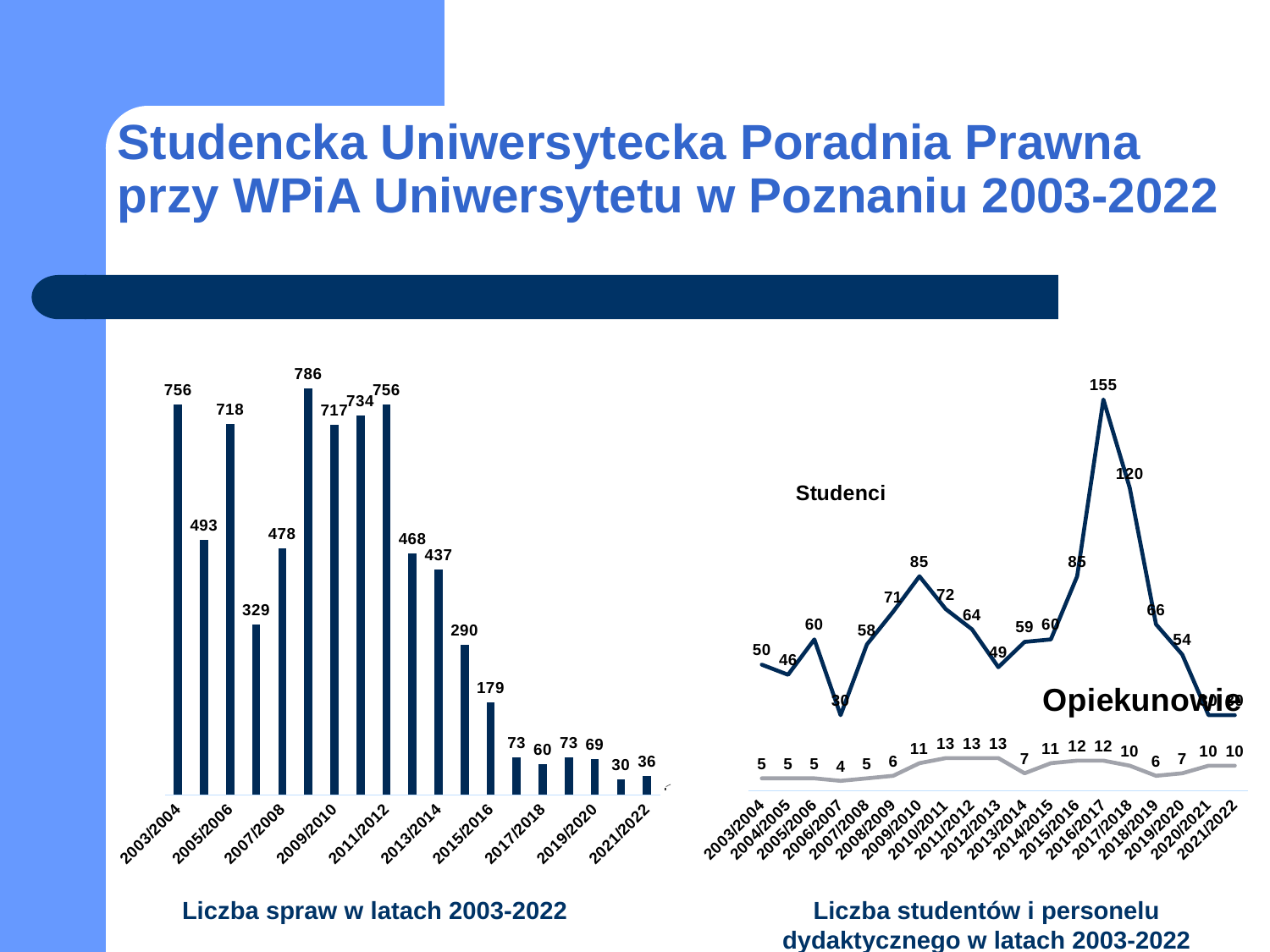
In the right chart 'Liczba studentów i personelu dydaktycznego w latach 2003-2022', what is the Studenci value for 2009/2010? 85 In the left chart 'Liczba spraw w latach 2003-2022', what is the value for 2003/2004? 756 How many series are plotted in the right chart 'Liczba studentów i personelu dydaktycznego w latach 2003-2022'? 2 In the right chart 'Liczba studentów i personelu dydaktycznego w latach 2003-2022', in which year does the Studenci series reach its highest value? 2016/2017 In the left chart 'Liczba spraw w latach 2003-2022', do the values rise or fall from 2011/2012 to 2021/2022? fall How many bars are plotted in the left chart 'Liczba spraw w latach 2003-2022'? 19 In the right chart 'Liczba studentów i personelu dydaktycznego w latach 2003-2022', what is the Opiekunowie value for 2006/2007? 4 In the left chart 'Liczba spraw w latach 2003-2022', which has the larger value, 2005/2006 or 2007/2008? 2005/2006 In the left chart 'Liczba spraw w latach 2003-2022', what is the difference between the values for 2003/2004 and 2021/2022? 720 What kind of chart is the left chart, 'Liczba spraw w latach 2003-2022'? bar chart In the left chart 'Liczba spraw w latach 2003-2022', what is the highest value shown? 786 In the left chart 'Liczba spraw w latach 2003-2022', what is the value for 2021/2022? 36